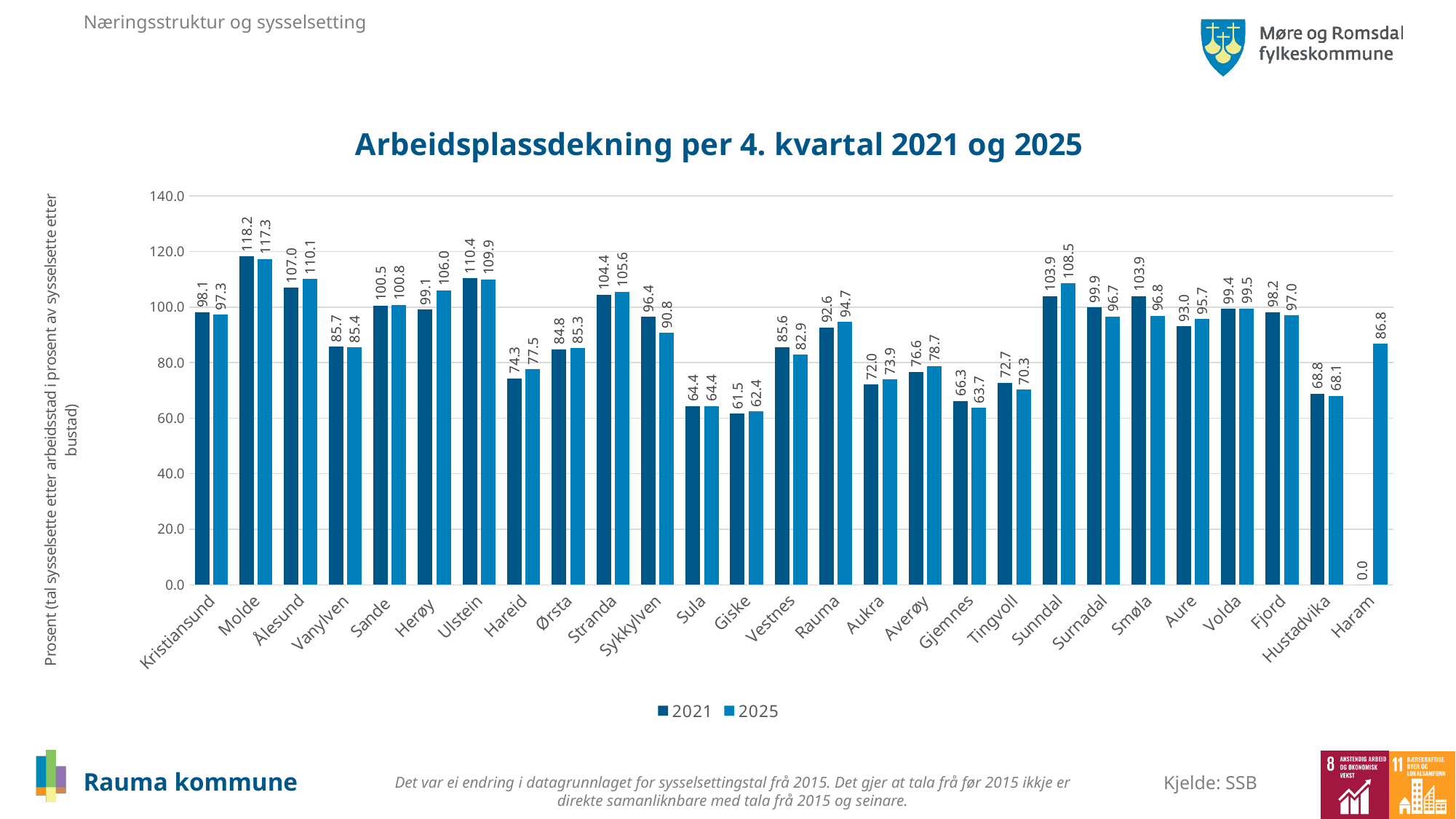
What is the value for Rauma in 2021? 92.6 What is the difference between the 2025 and 2021 values for Rauma? 2.1 How many municipalities are shown on the x axis? 27 What is the value for Molde in 2025? 117.3 Which municipality has the lowest value in 2025? Giske Which is larger: the 2025 value for Sunndal or the 2025 value for Smøla? Sunndal What is the value for Haram in 2025? 86.8 Is the 2021 value for Ulstein greater or less than 100? greater Which municipality has the highest value in 2021? Molde How many series does the legend list? 2 What kind of chart is shown on the slide? bar chart What is the difference between the 2021 and 2025 values for Sykkylven? 5.6